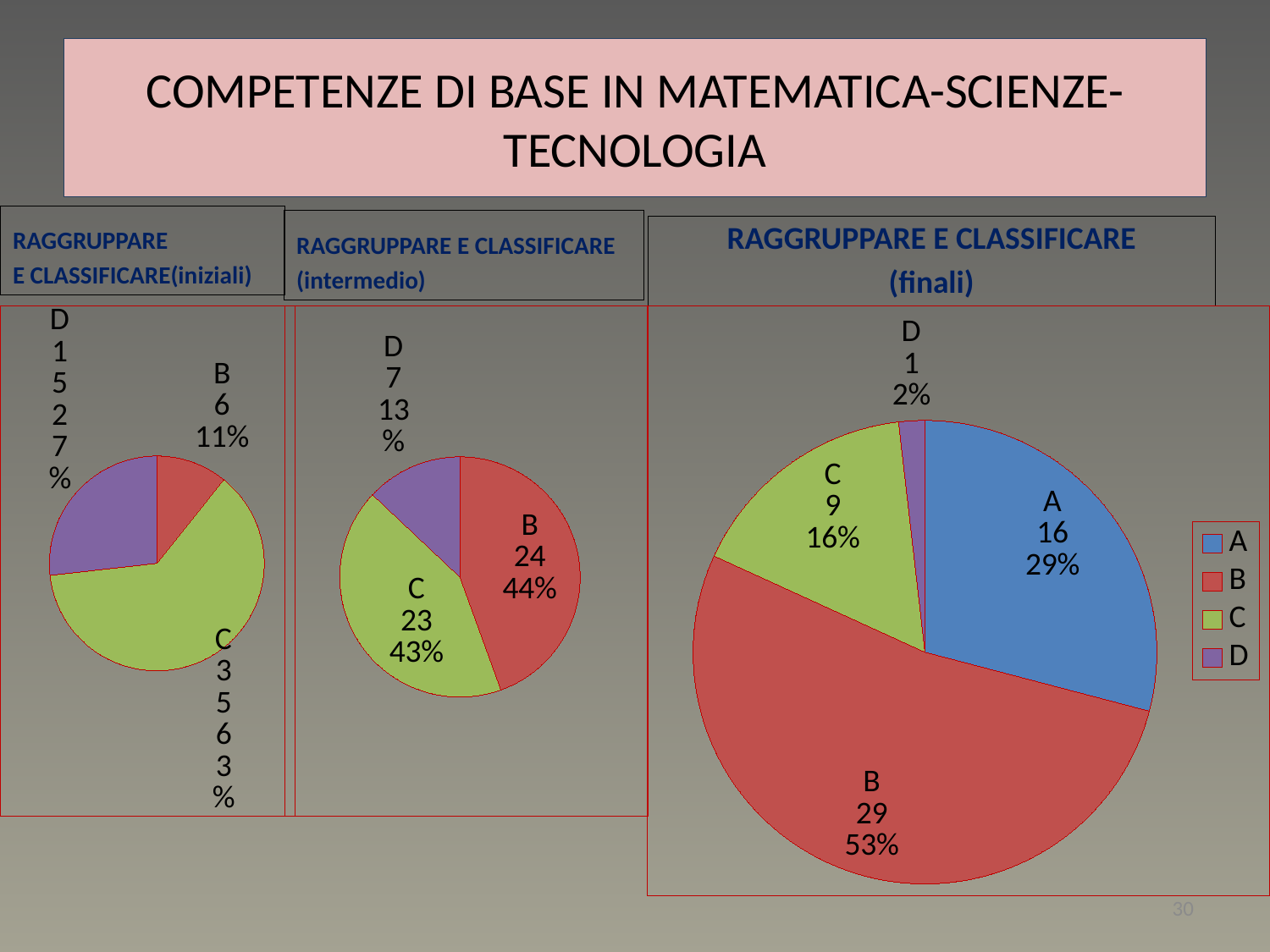
On the RAGGRUPPARE E CLASSIFICARE (finali) chart, what percentage share does slice B have? 53% What type of chart is the RAGGRUPPARE E CLASSIFICARE (finali) chart? Pie chart On the RAGGRUPPARE E CLASSIFICARE (intermedio) chart, what percentage share does slice D have? 13% On the RAGGRUPPARE E CLASSIFICARE (iniziali) chart, what percentage share does slice B have? 11% On the RAGGRUPPARE E CLASSIFICARE (intermedio) chart, which category has the smallest slice? D On the RAGGRUPPARE E CLASSIFICARE (finali) chart, which category has the largest slice? B On the RAGGRUPPARE E CLASSIFICARE (finali) chart, which category has the smallest slice? D On the RAGGRUPPARE E CLASSIFICARE (finali) chart, what is the value for category A? 16 On the RAGGRUPPARE E CLASSIFICARE (intermedio) chart, what is the value for category B? 24 On the RAGGRUPPARE E CLASSIFICARE (finali) chart, what is the difference between the values for B and A? 13 How many entries does the legend of the RAGGRUPPARE E CLASSIFICARE (finali) chart list? 4 On the RAGGRUPPARE E CLASSIFICARE (iniziali) chart, which category has the largest slice? C